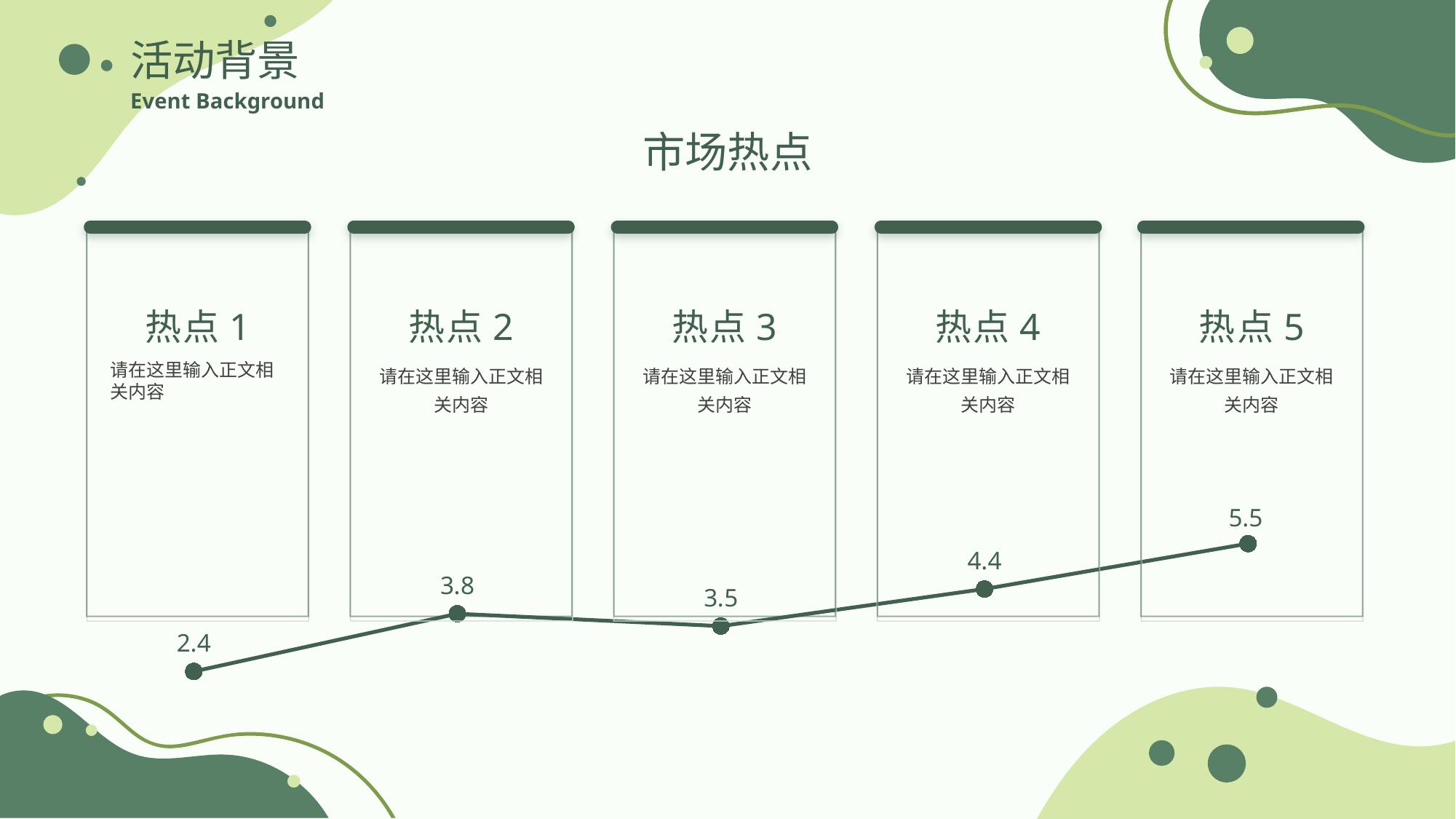
Which point on the line chart has the lowest value? 热点 1 Which point on the line chart has the highest value? 热点 5 What is the difference between the values for 热点 5 and 热点 1? 3.1 How many data points are plotted on the line chart? 5 Do the values on the line chart generally rise or fall from left to right? rise What is the value of the data point under 热点 1? 2.4 What type of chart is shown on the slide? line chart What is the title shown above the five cards on the slide? 市场热点 What is the difference between the values for 热点 2 and 热点 3? 0.3 Which is larger, the value for 热点 2 or the value for 热点 4? 热点 4 What is the value of the data point under 热点 3? 3.5 What is the value of the data point under 热点 5? 5.5